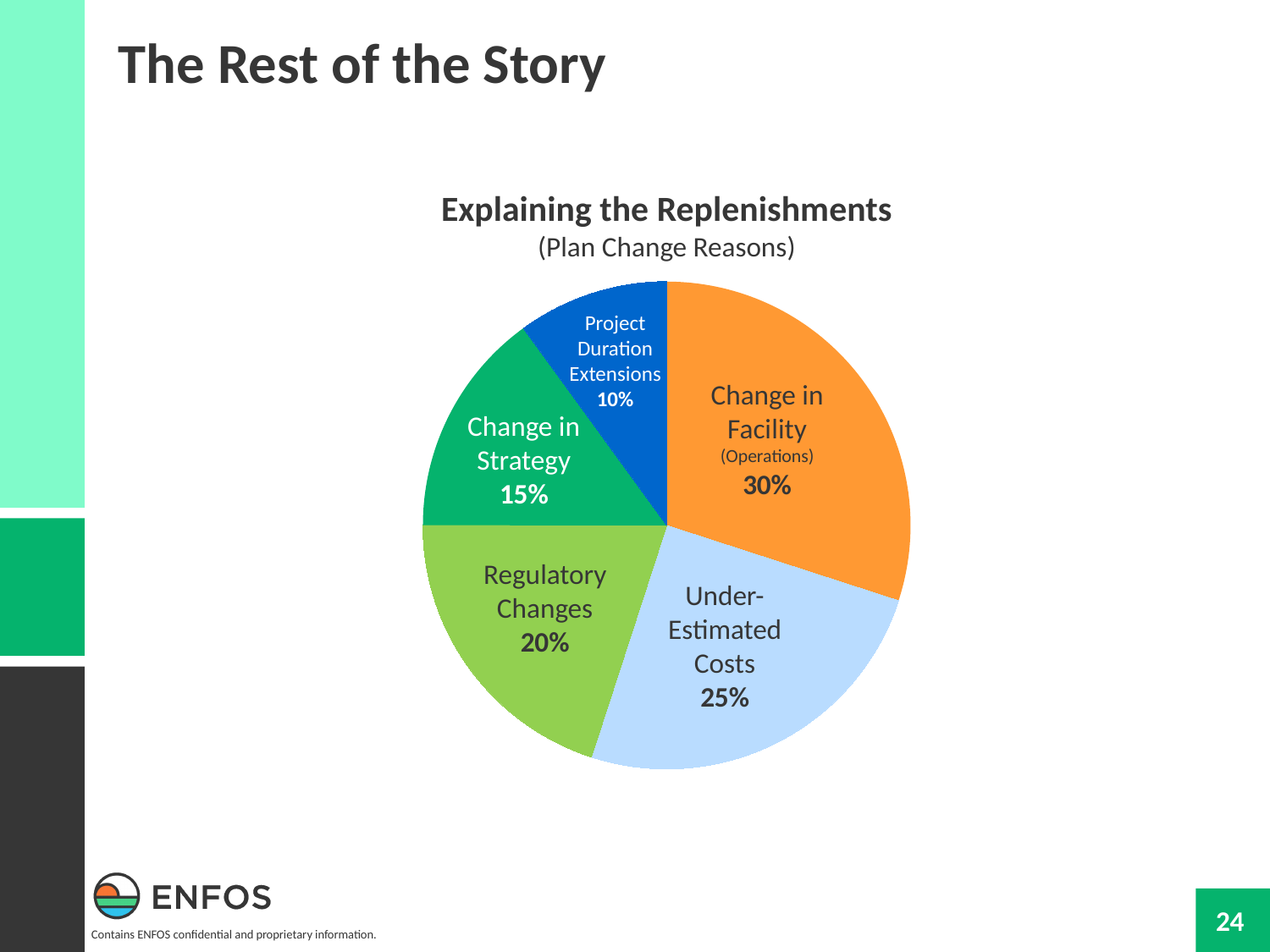
How many slices does the pie chart have? 5 Which plan change reason has the largest share of the pie? Change in Facility (Operations) What percentage is shown for Regulatory Changes? 20% What is the title of the chart? Explaining the Replenishments (Plan Change Reasons) What type of chart is shown on the slide? Pie chart What percentage is shown for Change in Strategy? 15% Which plan change reason has the smallest share of the pie? Project Duration Extensions What percentage is shown for Change in Facility (Operations)? 30% What percentage is shown for Project Duration Extensions? 10% What percentage is shown for Under-Estimated Costs? 25% Which is larger, Regulatory Changes or Under-Estimated Costs? Under-Estimated Costs What is the difference in percentage points between Change in Facility (Operations) and Change in Strategy? 15%